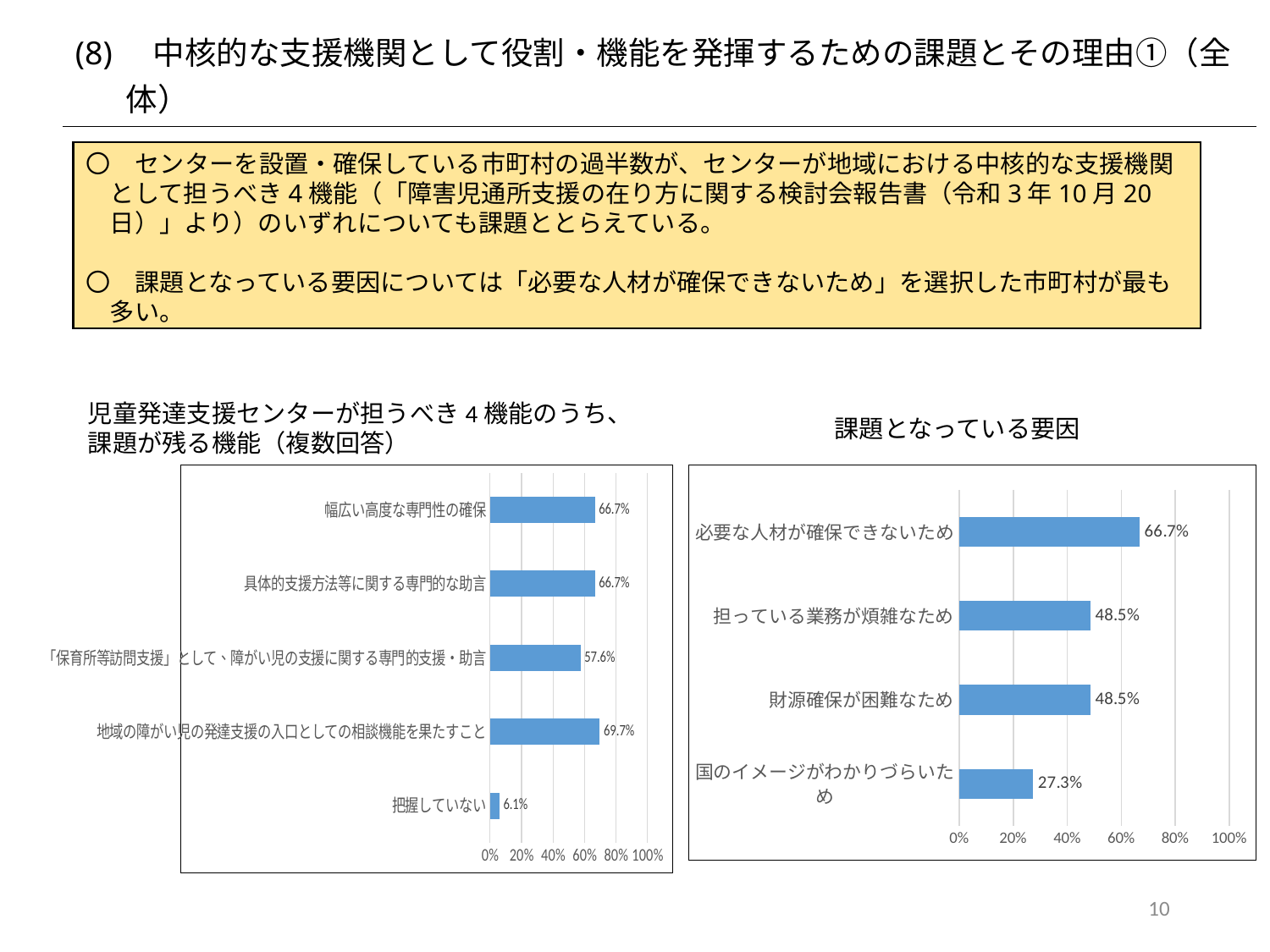
In the left chart (児童発達支援センターが担うべき4機能のうち、課題が残る機能), what is the value for 幅広い高度な専門性の確保? 66.7% In the left chart (児童発達支援センターが担うべき4機能のうち、課題が残る機能), which category has the highest value? 地域の障がい児の発達支援の入口としての相談機能を果たすこと In the right chart (課題となっている要因), what is the difference between 必要な人材が確保できないため and 担っている業務が煩雑なため? 18.2% In the left chart (児童発達支援センターが担うべき4機能のうち、課題が残る機能), what is the value for 把握していない? 6.1% In the left chart (児童発達支援センターが担うべき4機能のうち、課題が残る機能), which category has the lowest value? 把握していない In the right chart (課題となっている要因), which category has the highest value? 必要な人材が確保できないため In the right chart (課題となっている要因), what is the value for 国のイメージがわかりづらいため? 27.3% In the left chart (児童発達支援センターが担うべき4機能のうち、課題が残る機能), how many categories are shown? 5 In the right chart (課題となっている要因), what is the value for 必要な人材が確保できないため? 66.7% In the left chart (児童発達支援センターが担うべき4機能のうち、課題が残る機能), what is the difference between 地域の障がい児の発達支援の入口としての相談機能を果たすこと and 「保育所等訪問支援」として、障がい児の支援に関する専門的支援・助言? 12.1% What type of chart is the right chart (課題となっている要因)? Bar chart In the right chart (課題となっている要因), how many categories are shown? 4